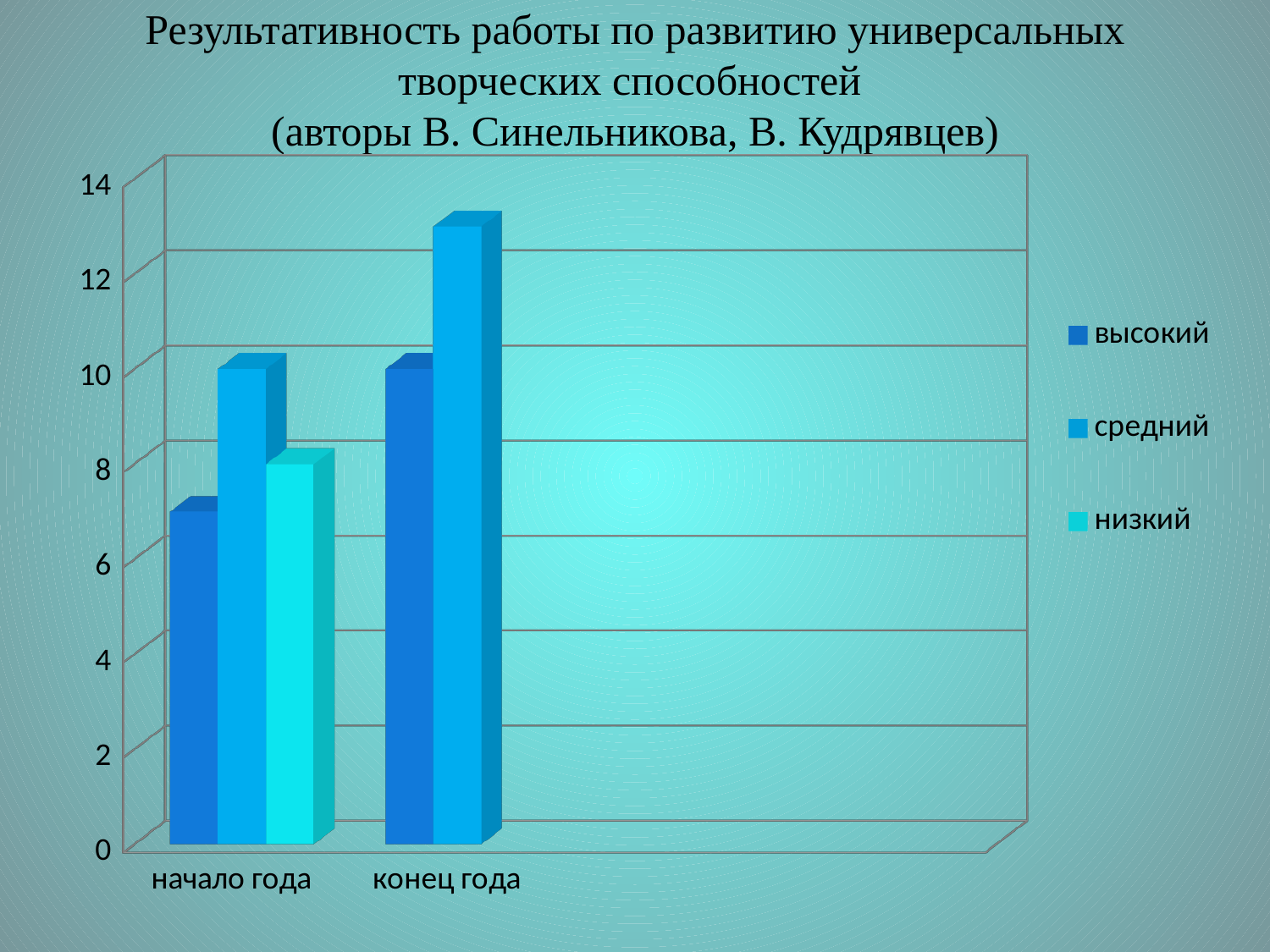
How many series does the chart legend list? 3 Is the value for "низкий" at "начало года" greater or less than 6? greater How many categories are shown on the x axis of the chart? 2 Which is larger: the value for "высокий" at "начало года" or at "конец года"? конец года Which series has the highest value for "конец года"? средний What are the three entries listed in the chart legend? высокий, средний, низкий Which series has the highest value for "начало года"? средний What kind of chart is shown on the slide? bar chart Is the value for "средний" at "конец года" greater or less than 12? greater Which series has the lowest value for "начало года"? высокий Is the value for "высокий" at "начало года" greater or less than 8? less Does the value for "средний" rise or fall from "начало года" to "конец года"? rise